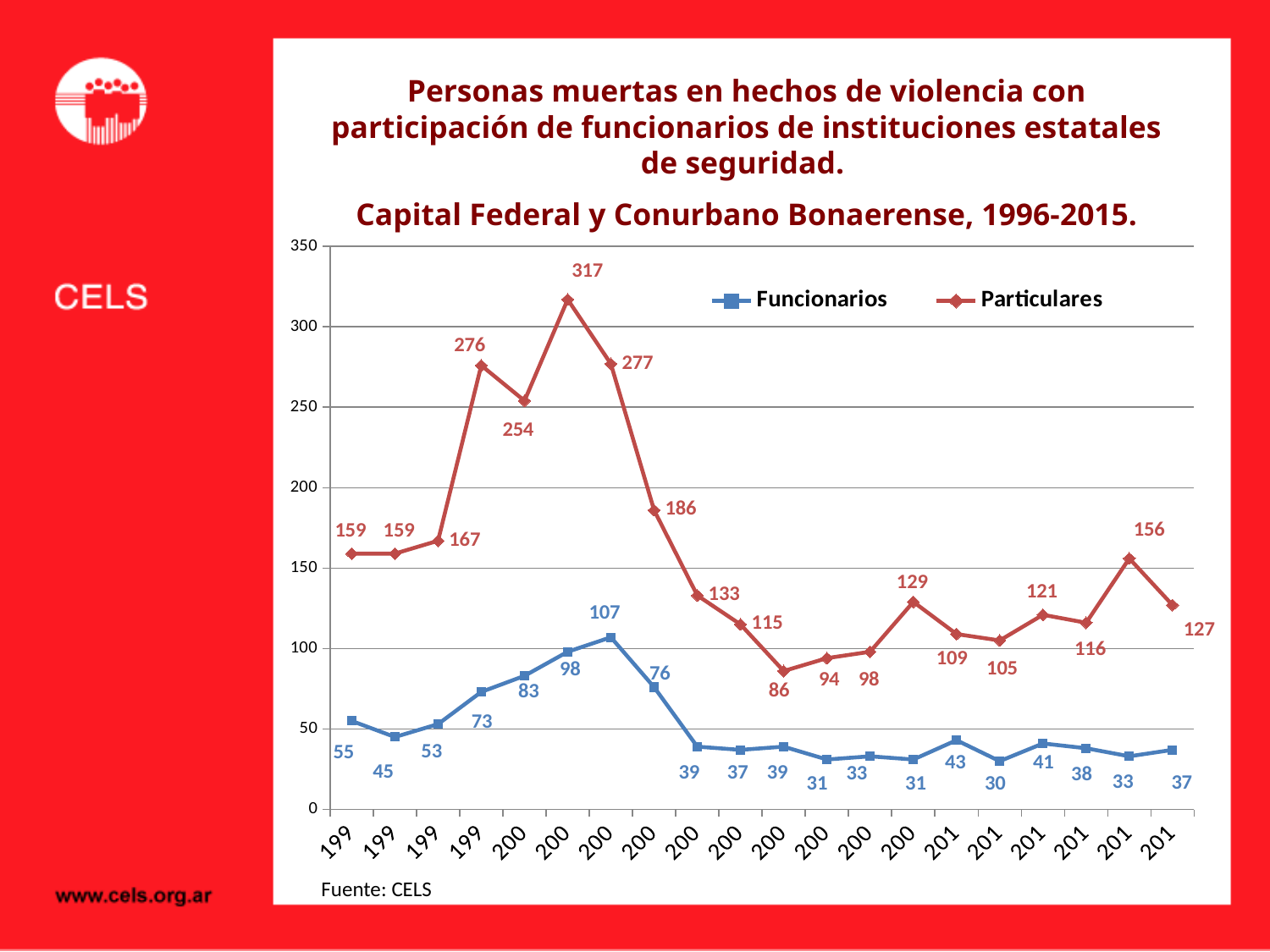
What is the value of the Particulares series at the last point on the x axis? 127 What is the value of the Funcionarios series at the last point on the x axis? 37 What is the lowest value in the Particulares series? 86 At the first point on the x axis, which series has the larger value, Funcionarios or Particulares? Particulares What kind of chart is shown on the slide? line chart What is the highest value reached by the Particulares series? 317 What is the highest value reached by the Funcionarios series? 107 What is the difference between the highest and lowest values of the Particulares series? 231 How many data points does each series have in the chart? 20 How many series does the legend list? 2 What source is cited below the chart? Fuente: CELS What is the lowest value in the Funcionarios series? 30